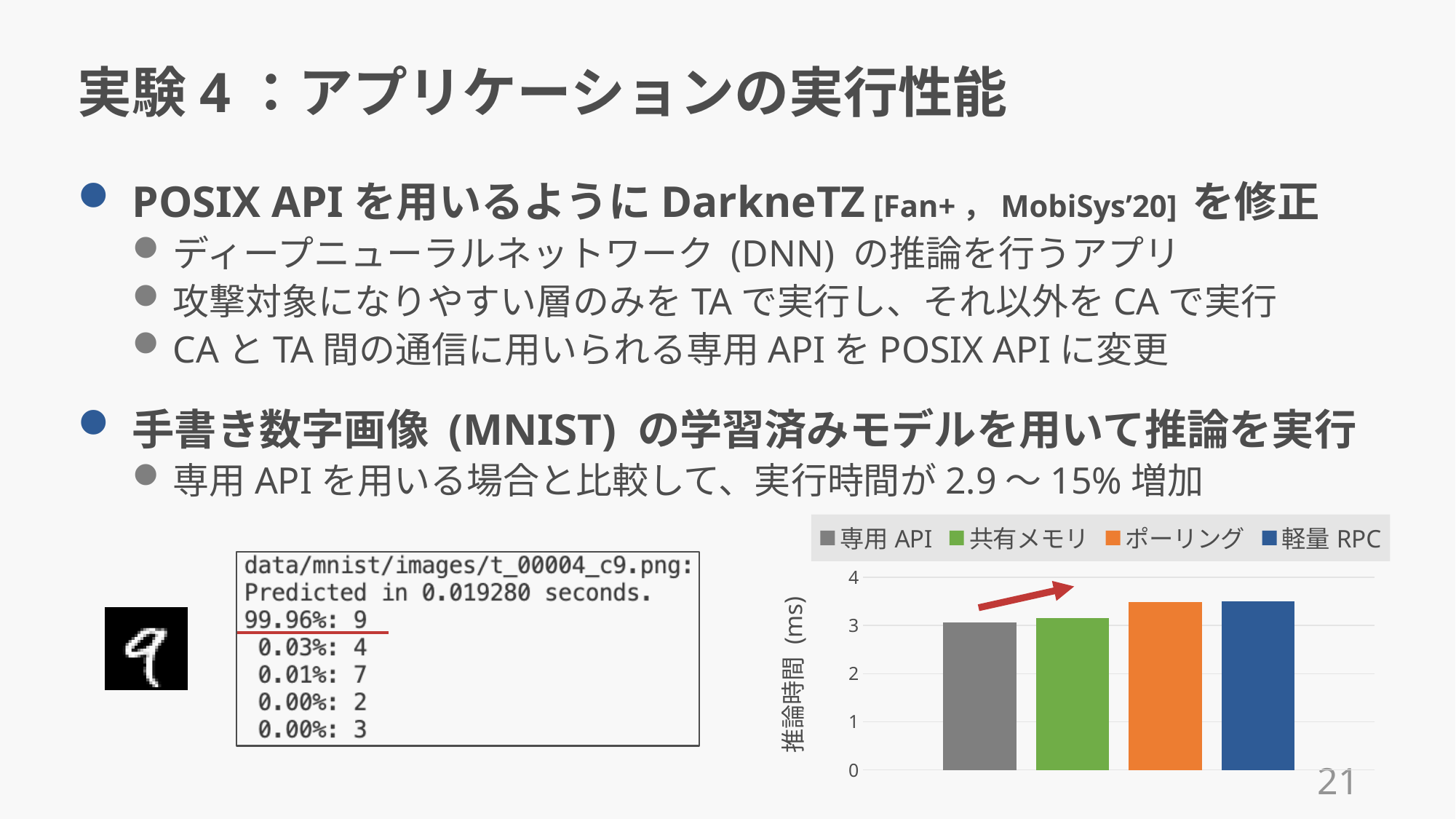
Which is larger, the value for 共有メモリ or the value for 軽量 RPC? 軽量 RPC Is the value for ポーリング greater or less than 4? less Is the value for 専用 API greater or less than 2? greater How many bars are plotted in the chart? 4 Do the bar values rise or fall from left to right across the chart? rise Which is larger, the value for 専用 API or the value for ポーリング? ポーリング Is the value for 軽量 RPC greater or less than 3? greater What kind of chart is shown on the slide? bar chart How many series does the chart's legend list? 4 What is the label of the chart's vertical axis? 推論時間 (ms)